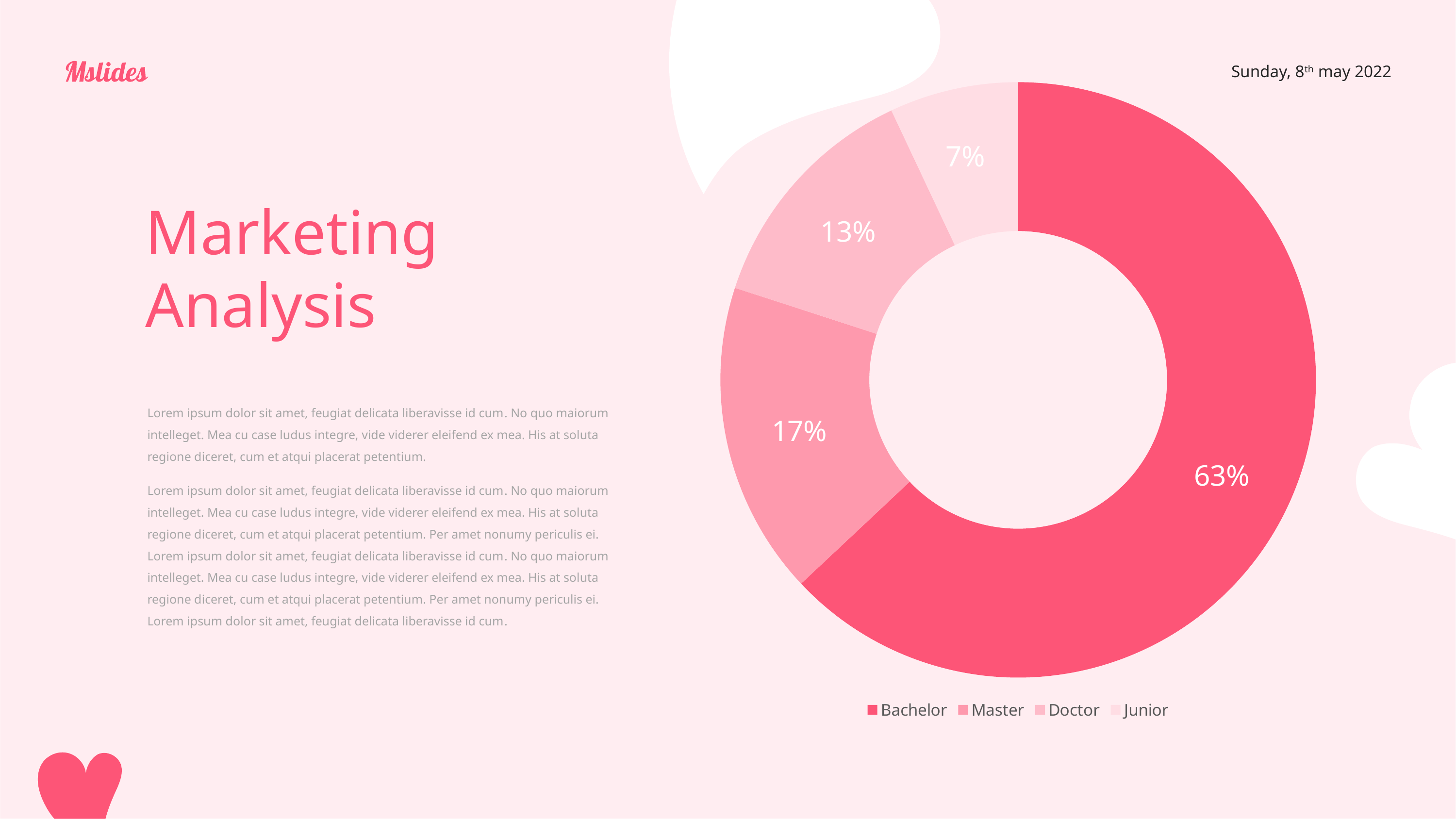
What percentage of the doughnut chart does Bachelor account for? 63% How many categories does the chart show? 4 What is the difference in percentage points between Bachelor and Master? 46 What percentage is shown for Doctor? 13% What percentage is shown for Junior? 7% Which category has the smallest share of the chart? Junior What are the legend entries listed below the chart? Bachelor, Master, Doctor, Junior What is the difference in percentage points between Doctor and Junior? 6 Which category has the largest share of the chart? Bachelor What percentage is shown for Master? 17% Which has a larger share, Master or Doctor? Master What type of chart is shown on the slide? Doughnut chart